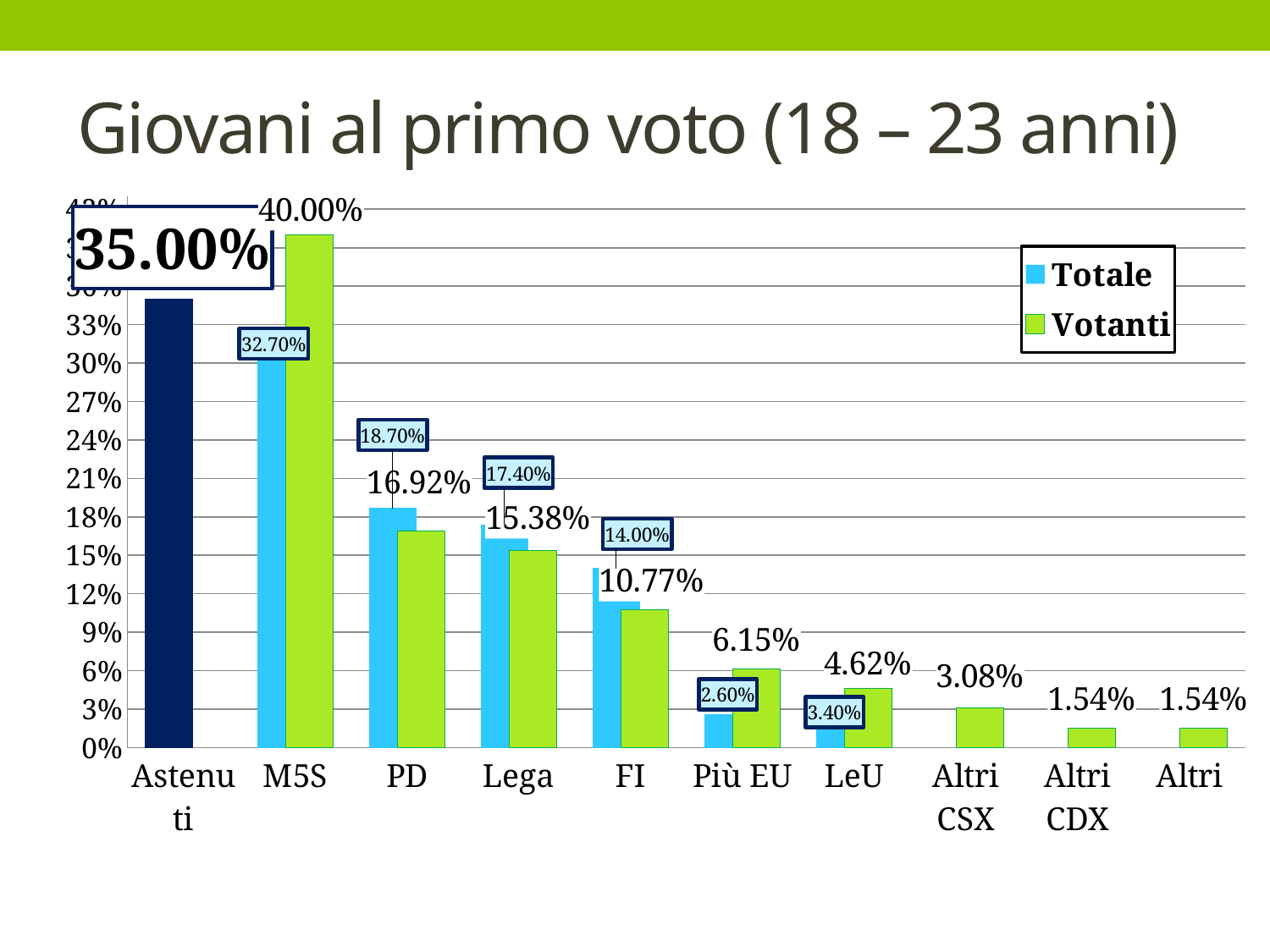
What is the title of the chart on the slide? Giovani al primo voto (18 – 23 anni) Which is larger for Più EU, the Totale value or the Votanti value? Votanti What is the difference between the Votanti and Totale values for M5S? 7.30% How many series does the legend list? 2 What is the value shown for Astenuti? 35.00% What is the Votanti value for M5S? 40.00% How many categories are shown on the x axis? 10 What is the Votanti value for Lega? 15.38% What is the Totale value for PD? 18.70% What type of chart is shown on the slide? bar chart What is the Totale value for M5S? 32.70% Which category has the highest Votanti value? M5S